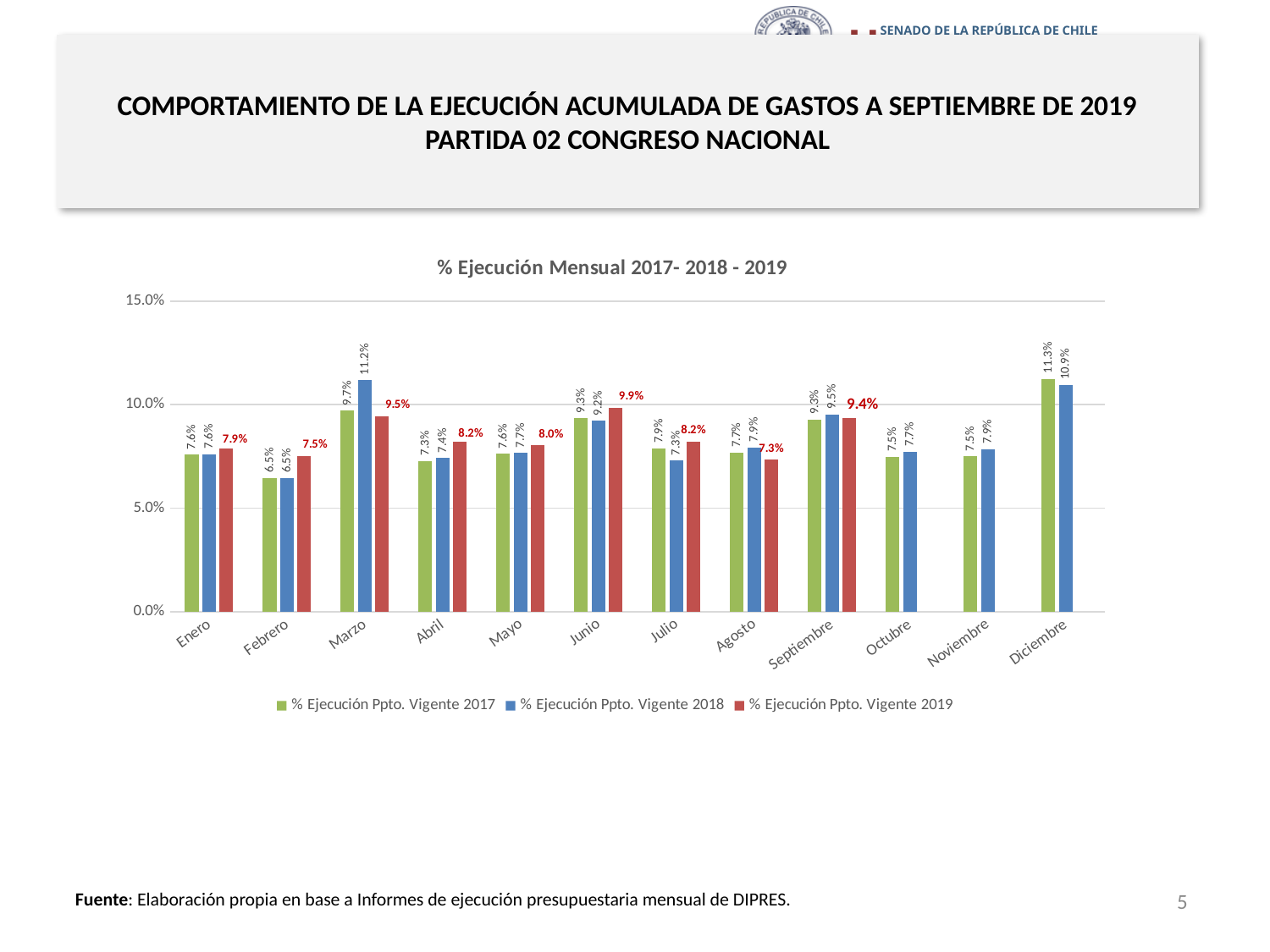
In which month is the % Ejecución Ppto. Vigente 2017 value lowest? Febrero What kind of chart is shown on the slide? Bar chart What is the value for % Ejecución Ppto. Vigente 2019 in Marzo? 9.5% How many months are shown on the x axis? 12 In Agosto, which is larger: the 2018 value or the 2019 value? 2018 (7.9%) What is the value for % Ejecución Ppto. Vigente 2017 in Septiembre? 9.3% How many series does the legend list? 3 In which month is the % Ejecución Ppto. Vigente 2018 value highest? Marzo What is the difference between the 2018 and 2017 values in Marzo? 1.5 percentage points Is the value for % Ejecución Ppto. Vigente 2017 in Diciembre greater or less than 10.0%? greater What is the value for % Ejecución Ppto. Vigente 2018 in Diciembre? 10.9% In which month is the % Ejecución Ppto. Vigente 2019 value highest? Junio